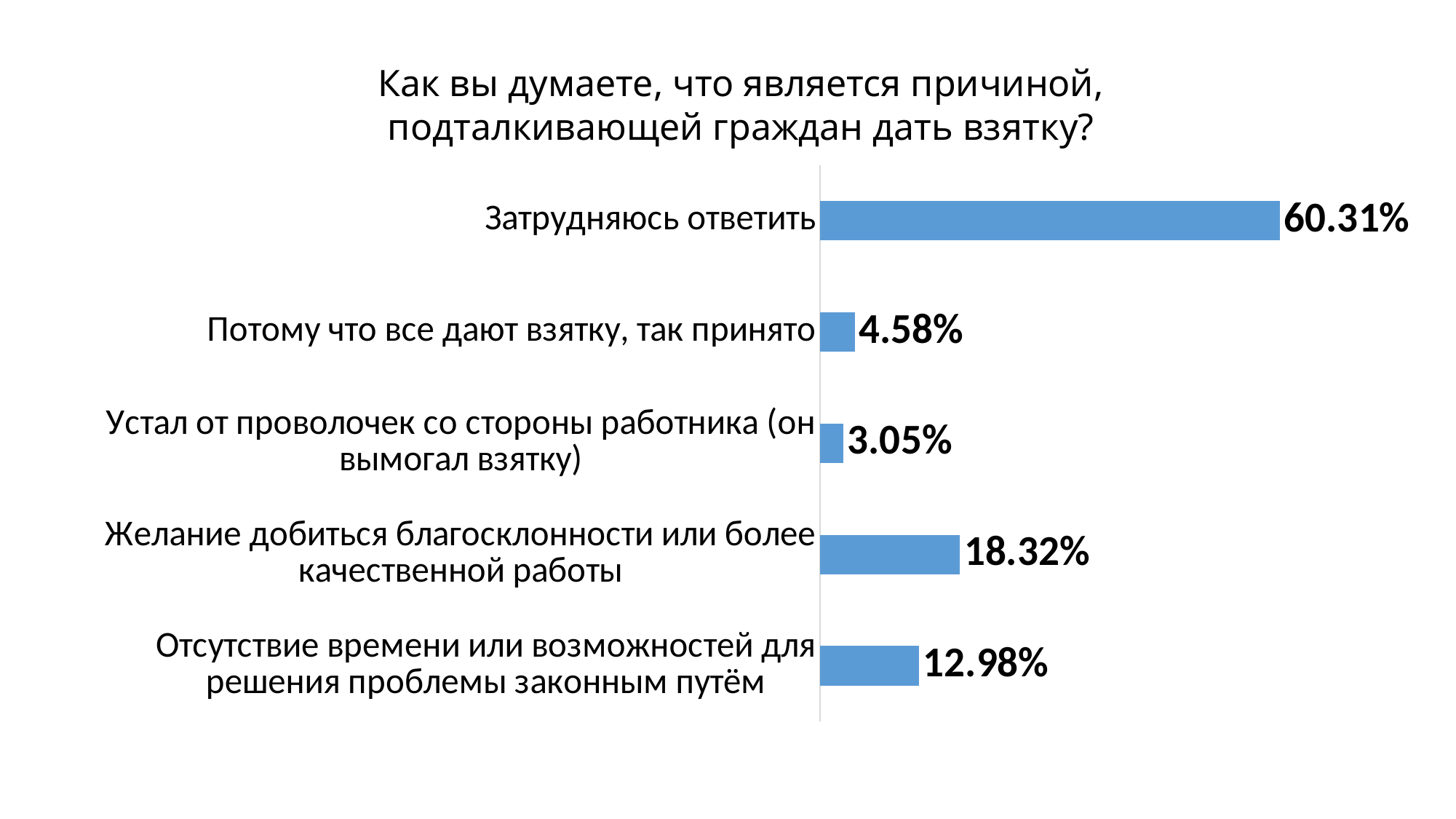
What is the value for "Потому что все дают взятку, так принято"? 4.58% Which is larger: the value for "Потому что все дают взятку, так принято" or the value for "Устал от проволочек со стороны работника (он вымогал взятку)"? Потому что все дают взятку, так принято What is the title of the chart? Как вы думаете, что является причиной, подталкивающей граждан дать взятку? What is the value for "Отсутствие времени или возможностей для решения проблемы законным путём"? 12.98% What is the value for "Устал от проволочек со стороны работника (он вымогал взятку)"? 3.05% Which category has the lowest value? Устал от проволочек со стороны работника (он вымогал взятку) How many categories are shown in the chart? 5 Which category has the highest value? Затрудняюсь ответить What is the difference between the values for "Желание добиться благосклонности или более качественной работы" and "Отсутствие времени или возможностей для решения проблемы законным путём"? 5.34% What kind of chart is shown on the slide? Bar chart What is the value for "Желание добиться благосклонности или более качественной работы"? 18.32% What is the value for "Затрудняюсь ответить"? 60.31%